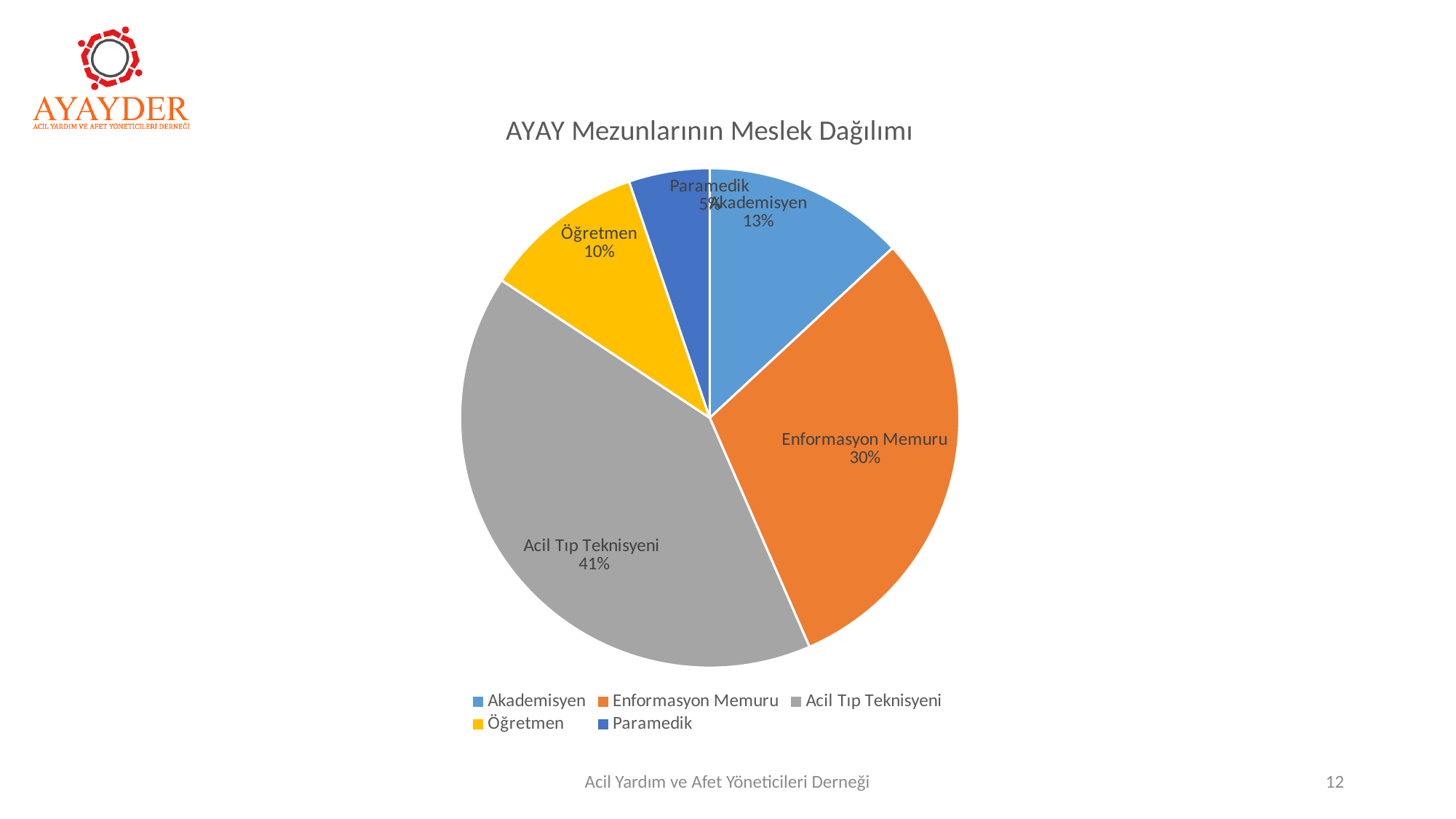
Which category has the smallest slice of the pie? Paramedik What percentage is shown for Akademisyen? 13% What share of the pie does Acil Tıp Teknisyeni represent? 41% What is the title of the chart? AYAY Mezunlarının Meslek Dağılımı What percentage is shown for Paramedik? 5% Which category has the largest slice of the pie? Acil Tıp Teknisyeni What is the difference in percentage points between Acil Tıp Teknisyeni and Enformasyon Memuru? 11 What percentage is shown for Enformasyon Memuru? 30% What type of chart is shown on the slide? pie chart What percentage is shown for Öğretmen? 10% How many categories does the legend list? 5 Which is larger, the share for Akademisyen or the share for Öğretmen? Akademisyen